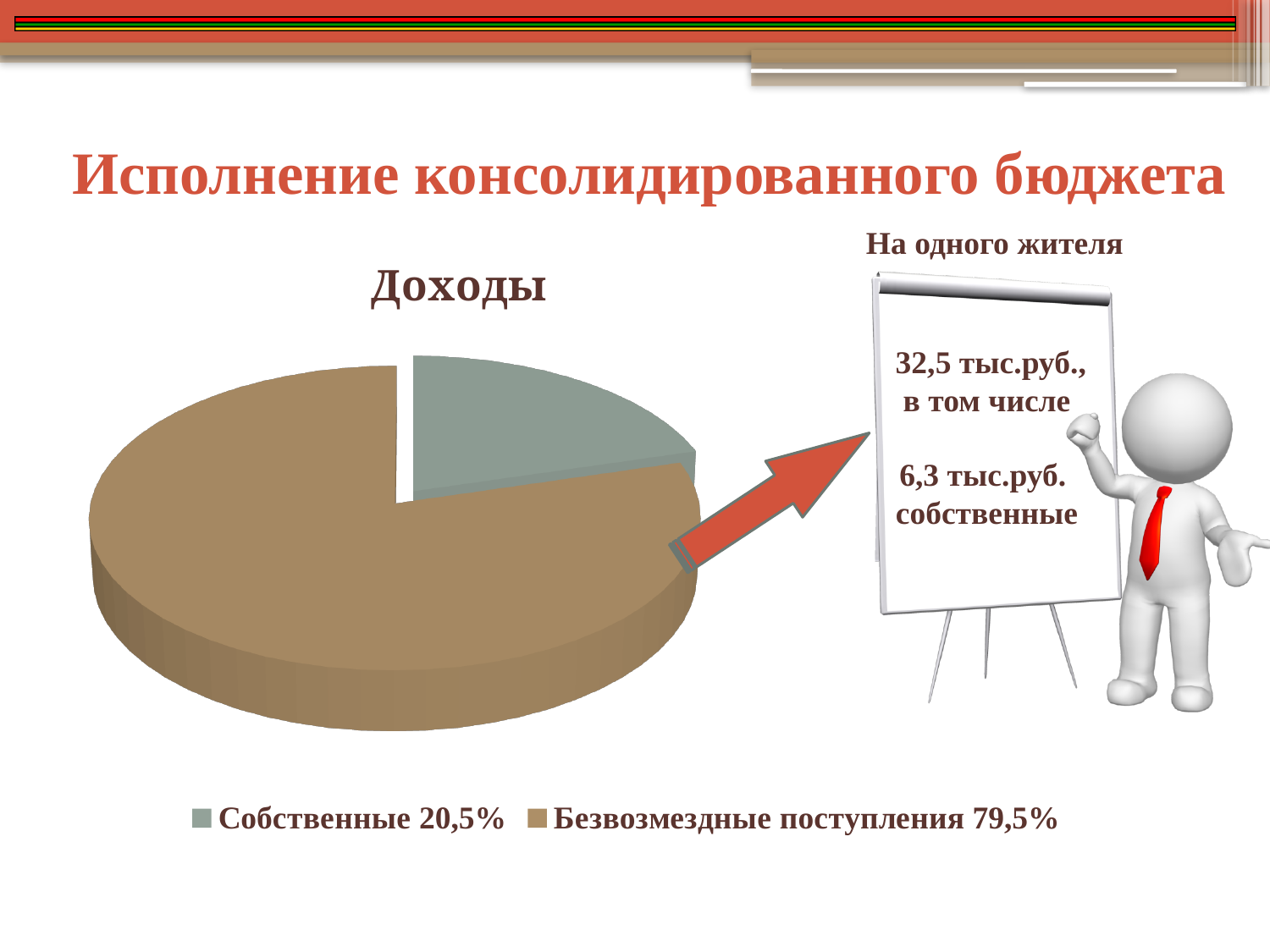
What kind of chart is shown under the title "Доходы"? pie chart Which is larger in the pie chart: "Собственные" or "Безвозмездные поступления"? Безвозмездные поступления What is the title of the chart on the slide? Доходы Which legend entry of the pie chart is shown in brown? Безвозмездные поступления 79,5% Is the share for "Собственные" in the pie chart greater or less than 25%? less What share of the pie does "Собственные" represent? 20,5% What share of the pie does "Безвозмездные поступления" represent? 79,5% Which slice of the pie chart is the smallest? Собственные What is the difference in percentage points between "Безвозмездные поступления" and "Собственные" in the pie chart? 59 percentage points How many slices does the pie chart have? 2 How many entries does the legend of the pie chart list? 2 Which slice of the pie chart is the largest? Безвозмездные поступления